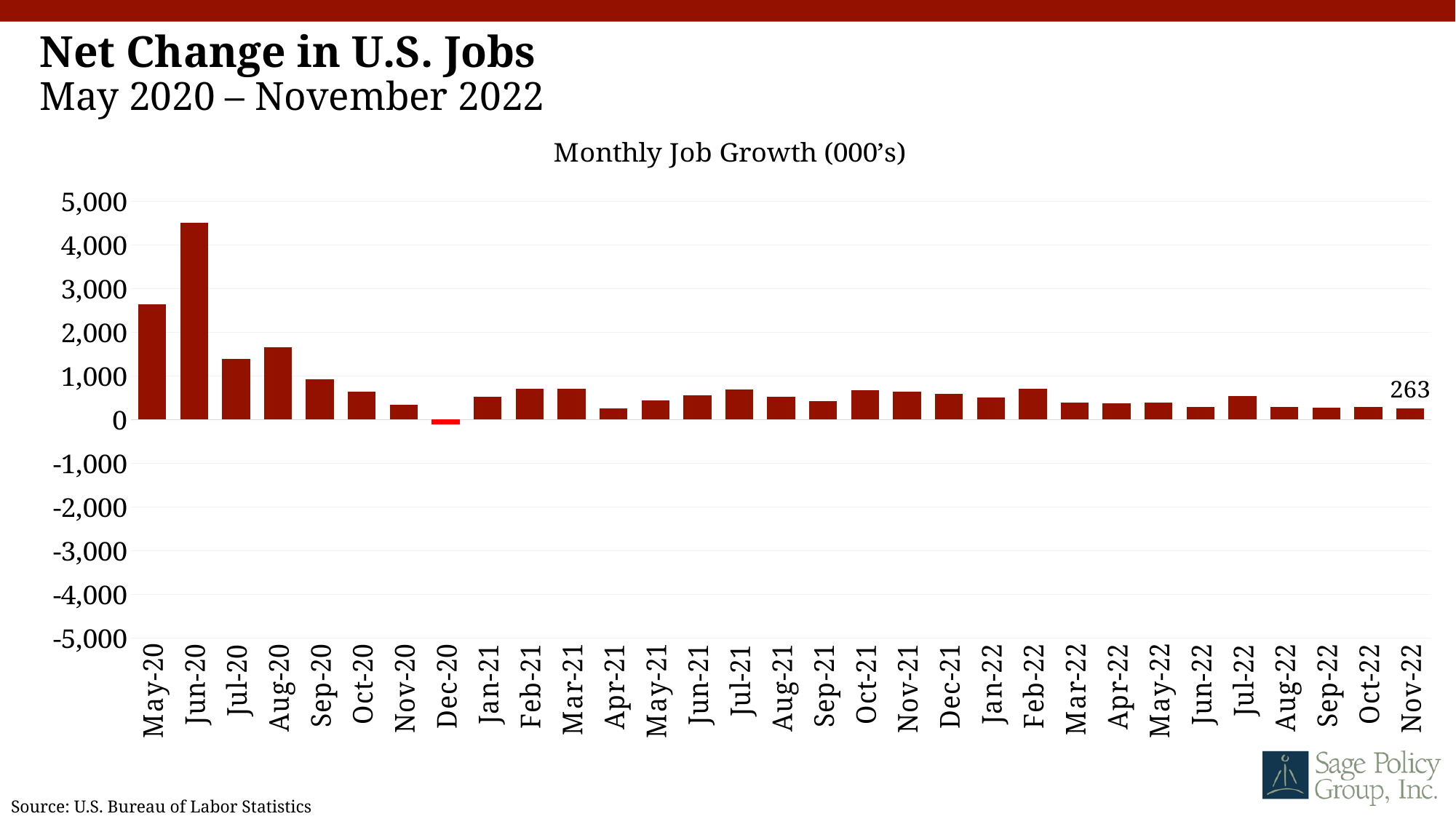
What is the value for Nov-22? 263 Do the values generally rise or fall from May-20 to Nov-20? fall Is the value for Dec-20 greater or less than 0? less Is the value for May-20 greater or less than 2,000? greater What is the title shown above the chart's plot area? Monthly Job Growth (000's) Which month has the highest value? Jun-20 Is the value for Aug-20 greater or less than 1,000? greater How many months are plotted on the chart? 31 What type of chart is shown on the slide? Bar chart Which is larger, the value for Jul-20 or the value for Aug-20? Aug-20 Which month has the lowest value? Dec-20